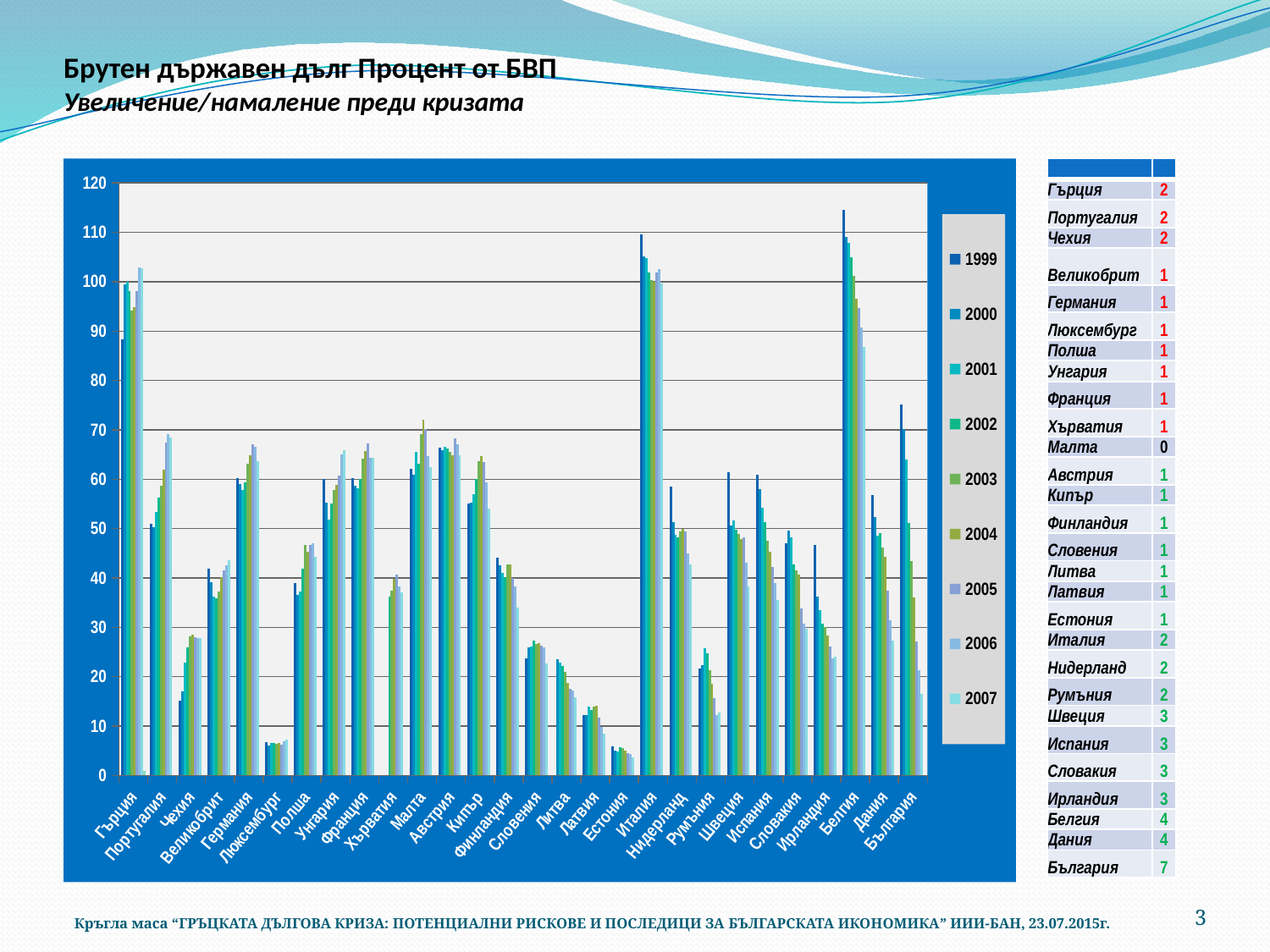
Which country has the tallest bar in the chart? Белгия Do the values for България rise or fall from 1999 to 2007? fall Is the value for Белгия in 1999 greater or less than 110? greater What kind of chart is shown on the slide? bar chart Is the value for Естония in 1999 greater or less than 10? less Is the value for Латвия in 2007 greater or less than 20? less How many series does the chart legend list? 9 Which country has the larger values in the chart, Италия or Германия? Италия Which year is the last series listed in the chart legend? 2007 How many countries are shown along the x axis of the chart? 28 Which year is the first series listed in the chart legend? 1999